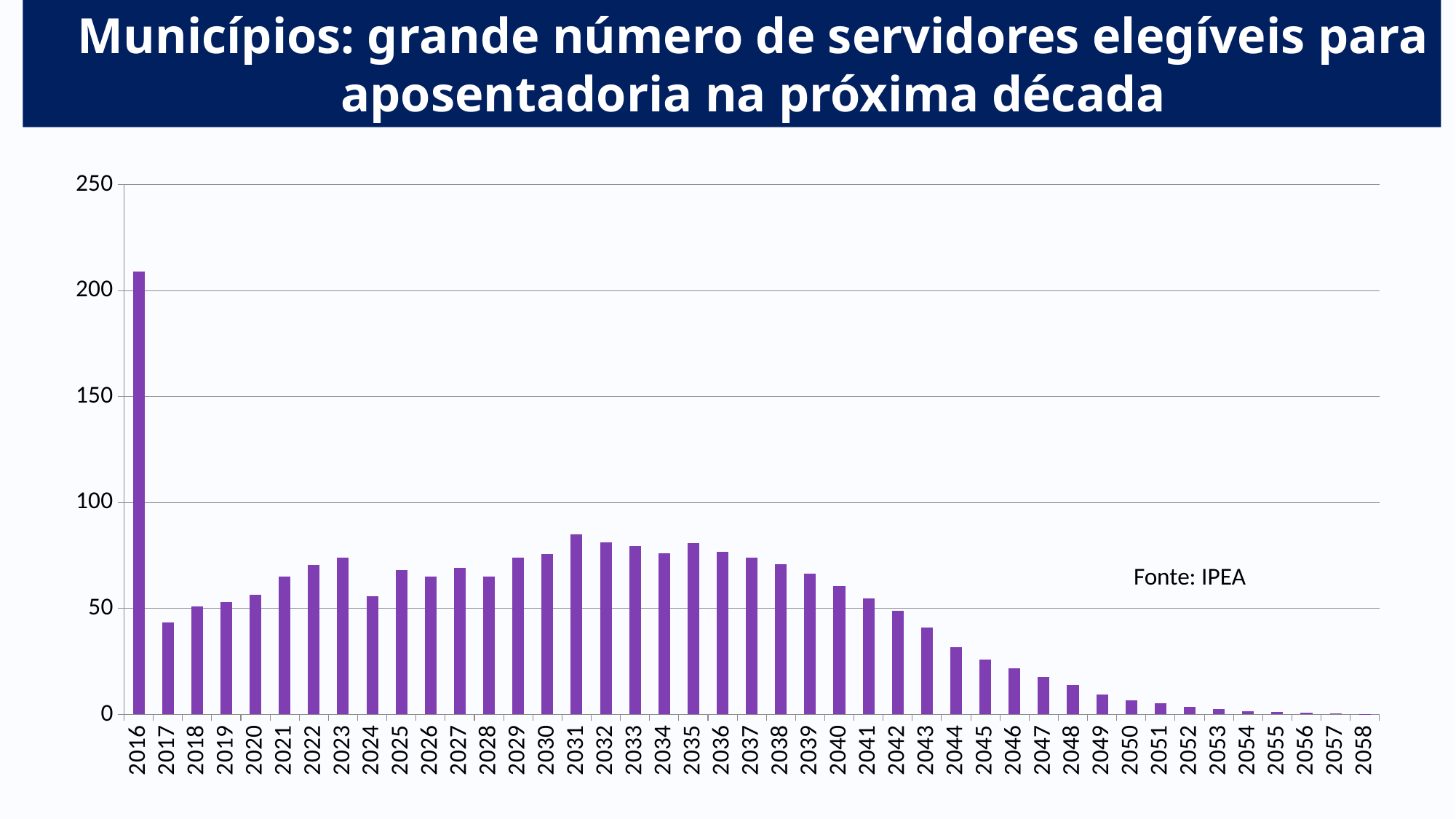
Which is larger, the value for 2043 or the value for 2049? 2043 Which is larger, the value for 2016 or the value for 2031? 2016 Is the value for 2031 greater or less than 100? less Is the value for 2017 greater or less than 50? less What kind of chart is shown on the slide? bar chart Do the values rise or fall from 2035 to 2058? fall Which year has the highest value in the chart? 2016 Is the value for 2044 greater or less than 50? less What source is cited for the chart data? IPEA How many years are shown on the x axis of the chart? 43